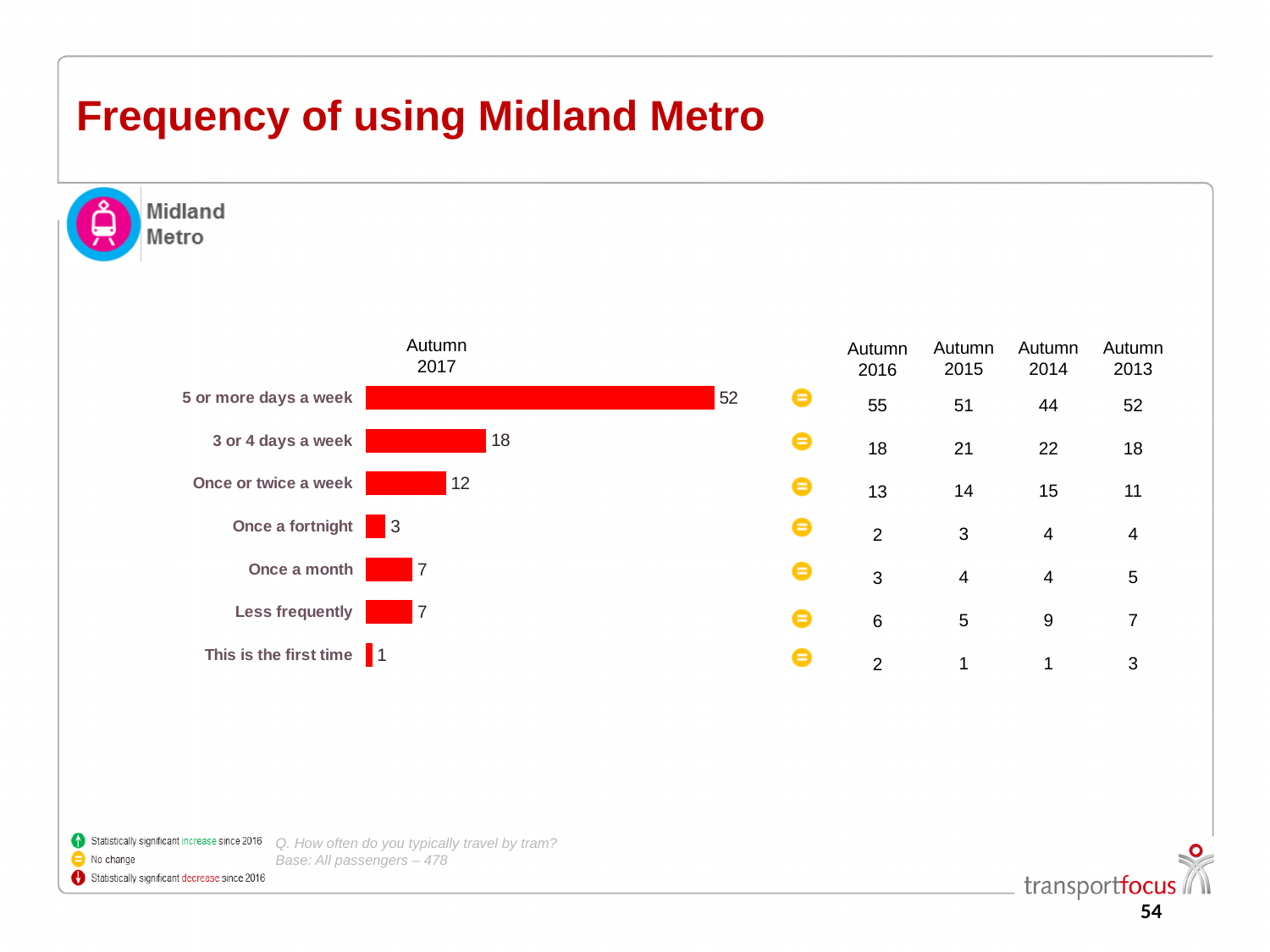
What is the difference between 'Once or twice a week' and 'Once a fortnight' in the Autumn 2017 bar chart? 9 What kind of chart is used to show the Autumn 2017 data? Bar chart What colour are the bars in the Autumn 2017 bar chart? Red What is the value for '5 or more days a week' in the Autumn 2017 bar chart? 52 What is the value for 'Once or twice a week' in the Autumn 2017 bar chart? 12 How many categories are shown in the Autumn 2017 bar chart? 7 What is the title of the slide containing the bar chart? Frequency of using Midland Metro Which category has the lowest value in the Autumn 2017 bar chart? This is the first time In the Autumn 2017 bar chart, which is larger: 'Once a fortnight' or 'Once a month'? Once a month Which category has the highest value in the Autumn 2017 bar chart? 5 or more days a week What is the difference between '5 or more days a week' and '3 or 4 days a week' in the Autumn 2017 bar chart? 34 What is the value for 'This is the first time' in the Autumn 2017 bar chart? 1